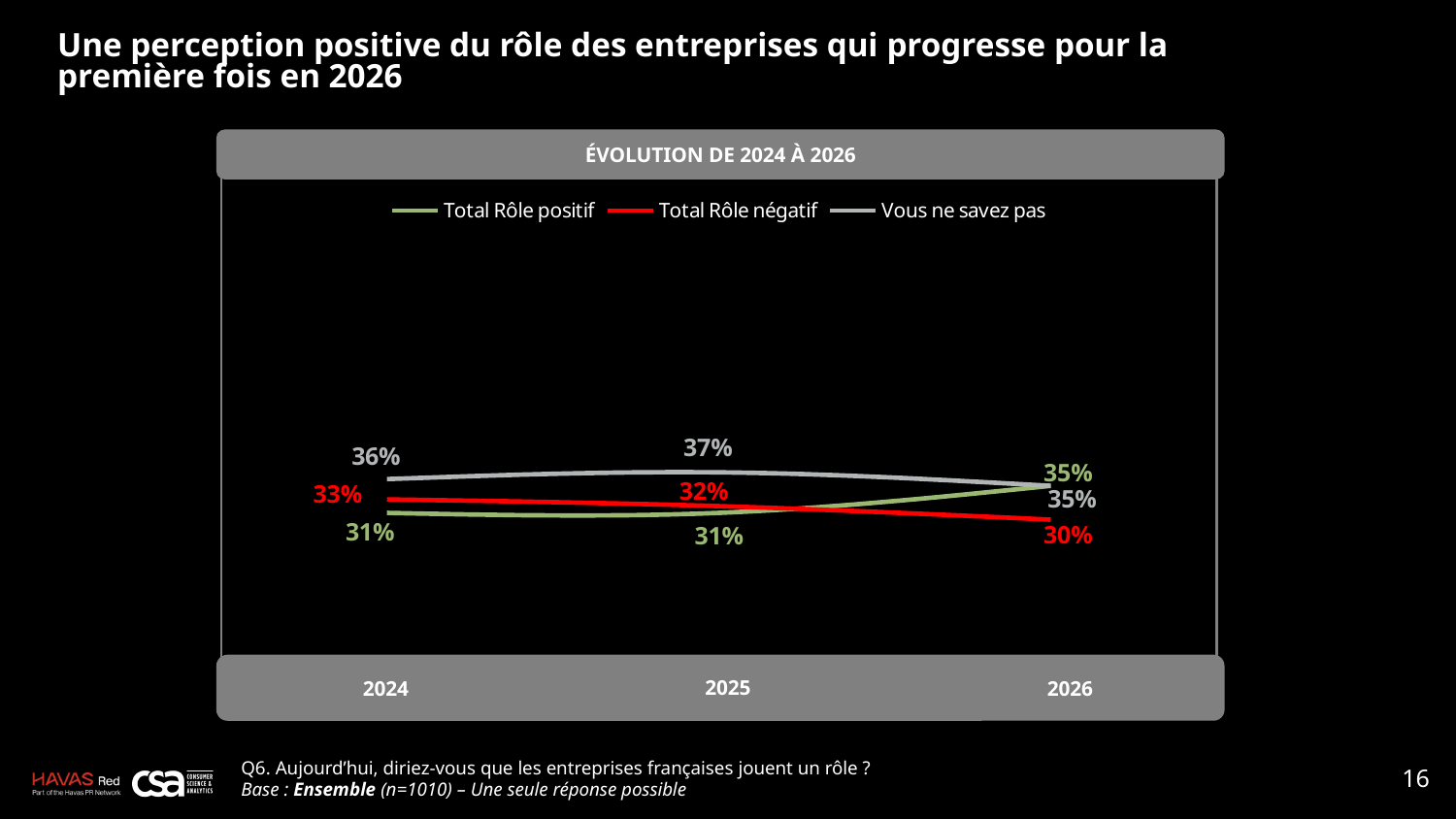
How many years are shown on the x axis? 3 In which year is Total Rôle négatif lowest? 2026 What is the value for Total Rôle positif in 2024? 31% What is the difference between Total Rôle positif in 2026 and in 2025? 4 percentage points Which is larger in 2024: Total Rôle négatif or Total Rôle positif? Total Rôle négatif What type of chart is shown on the slide? line chart What is the value for Vous ne savez pas in 2025? 37% In which year is Vous ne savez pas highest? 2025 Does Total Rôle négatif rise or fall from 2024 to 2026? fall How many series does the legend list? 3 What is the value for Total Rôle positif in 2026? 35% What is the value for Total Rôle négatif in 2026? 30%